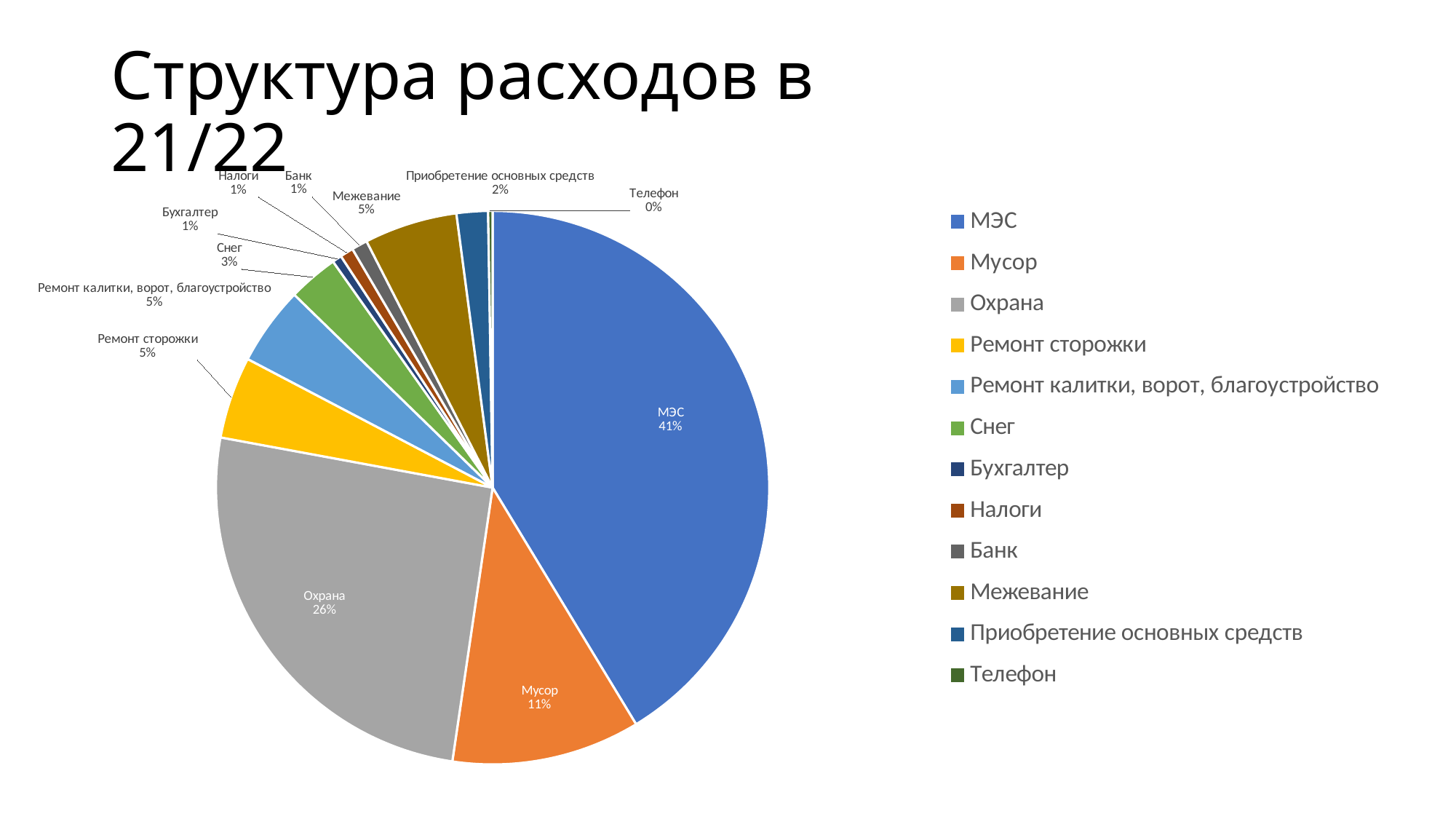
Which has a larger share, Мусор or Ремонт сторожки? Мусор What share of expenses does Охрана account for? 26% Which category has the smallest share of expenses? Телефон What share of expenses does Мусор account for? 11% What share of expenses does Приобретение основных средств account for? 2% How many categories does the legend list? 12 Which category has the largest share of expenses? МЭС What is the difference in percentage points between the shares of МЭС and Охрана? 15 What kind of chart is shown on the slide? pie chart